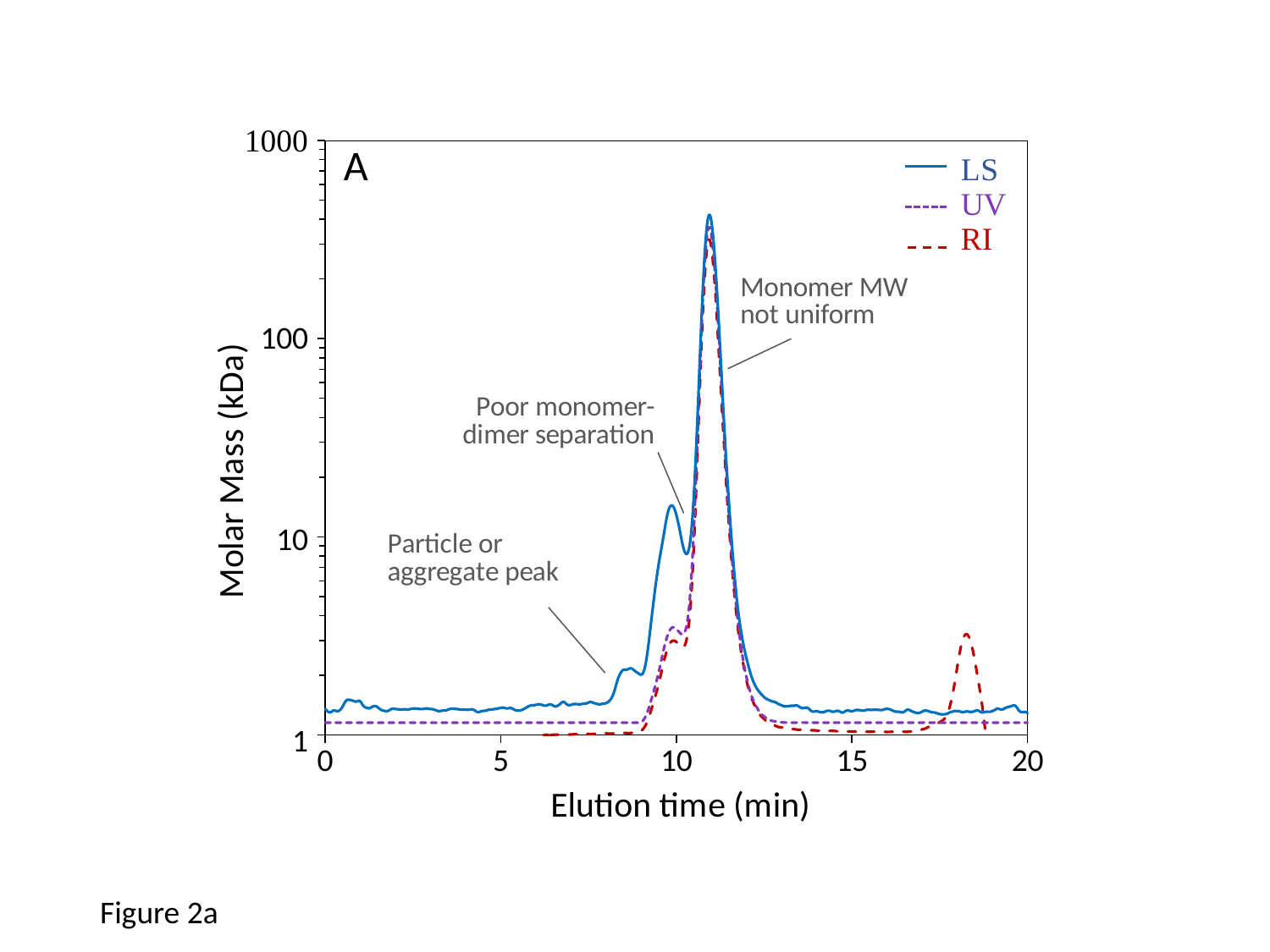
Is the peak of the RI series near 18 min greater or less than 10? less Which annotation points to the small peak near an elution time of 8 to 9 min? Particle or aggregate peak Is the peak value of the LS series greater or less than 100? greater What kind of chart is shown on the slide? Line chart What is the label of the x axis? Elution time (min) How many series does the legend list? 3 Is the value of the UV series at an elution time of 15 min greater or less than 10? less What are the series names listed in the legend? LS, UV, RI Which series shows a distinct peak near an elution time of 18 min? RI